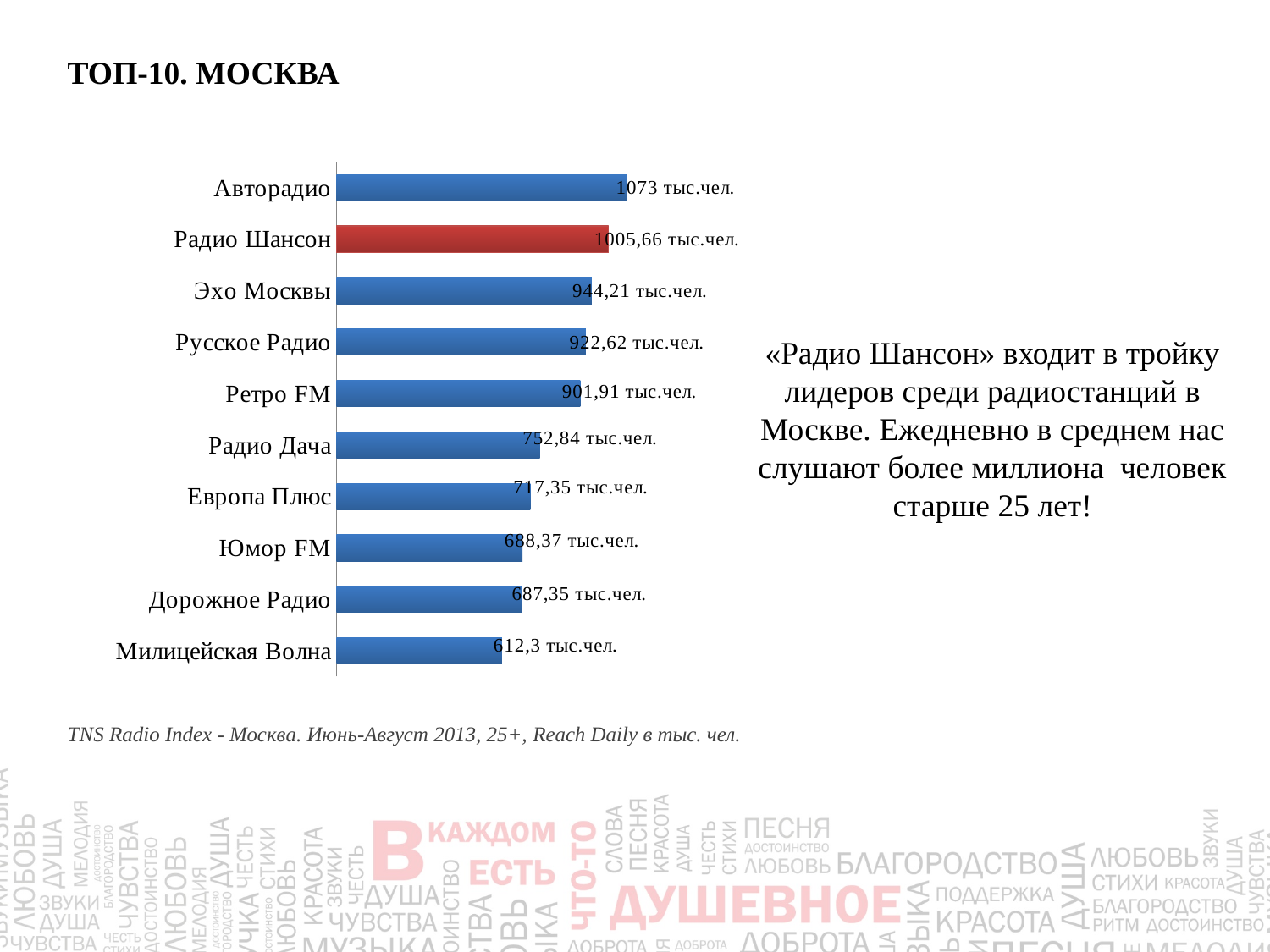
Which radio station has the highest value? Авторадио What is the value for Радио Шансон? 1005,66 тыс.чел. What kind of chart is shown on the slide? Bar chart How many radio stations are shown in the chart? 10 Which has a larger value, Радио Дача or Европа Плюс? Радио Дача What is the value for Ретро FM? 901,91 тыс.чел. What is the value for Милицейская Волна? 612,3 тыс.чел. What is the difference between the values for Авторадио and Радио Шансон? 67,34 тыс.чел. Which radio station has the lowest value? Милицейская Волна What is the value for Авторадио? 1073 тыс.чел. Which radio station's bar is coloured red? Радио Шансон What is the difference between the values for Эхо Москвы and Русское Радио? 21,59 тыс.чел.